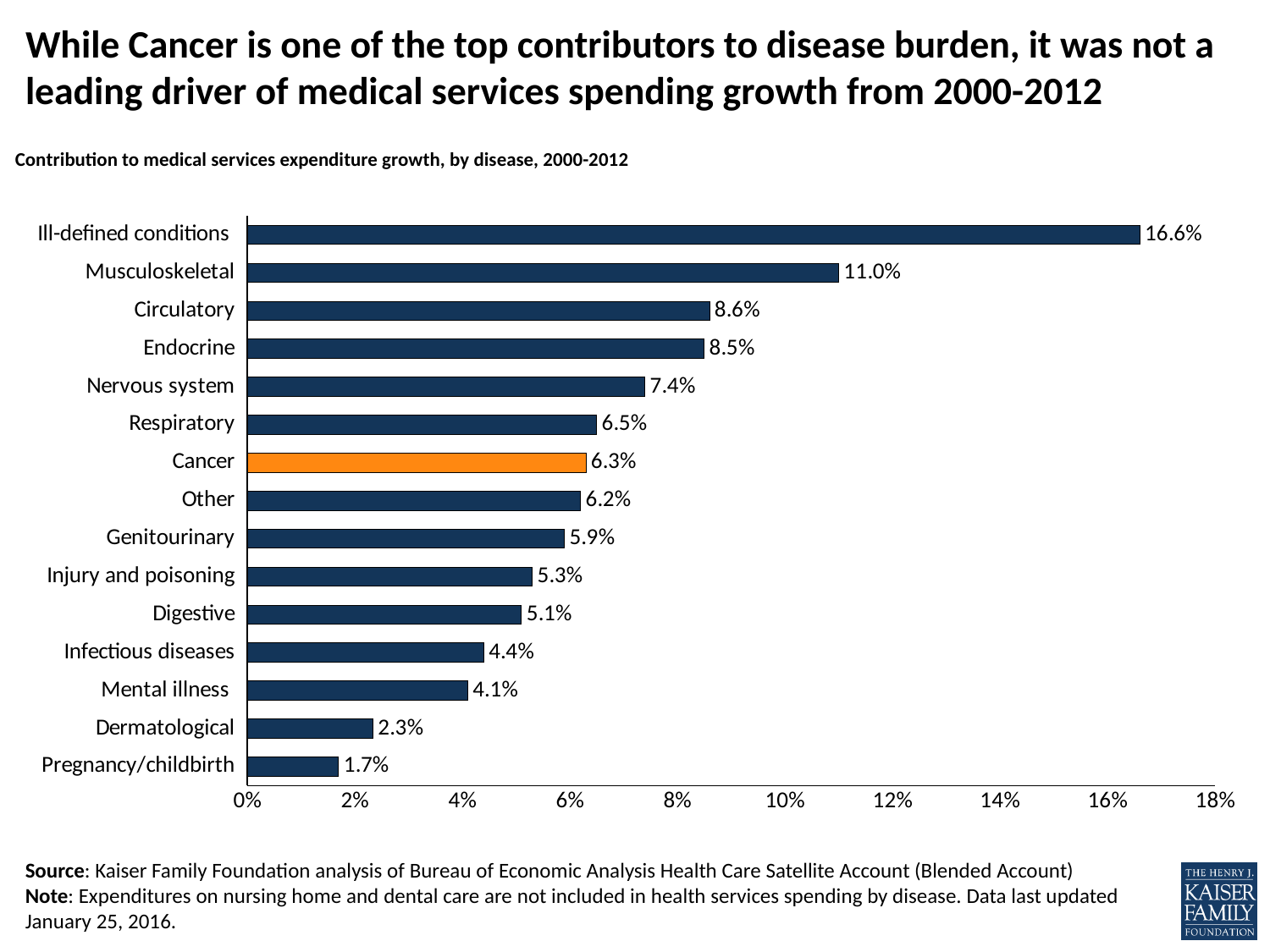
Is the value for Respiratory greater or less than 6%? greater Which disease category has the highest contribution to medical services expenditure growth? Ill-defined conditions What is the difference between the values for Ill-defined conditions and Musculoskeletal? 5.6% Which bar is highlighted in orange? Cancer Which disease category has the lowest contribution to medical services expenditure growth? Pregnancy/childbirth What is the difference between the values for Cancer and Mental illness? 2.2% What type of chart is shown on the slide? Bar chart Which has a larger value, Circulatory or Nervous system? Circulatory What is the contribution to medical services expenditure growth for Cancer? 6.3% How many disease categories are shown in the chart? 15 What is the value shown for Musculoskeletal? 11.0% What is the value shown for Pregnancy/childbirth? 1.7%